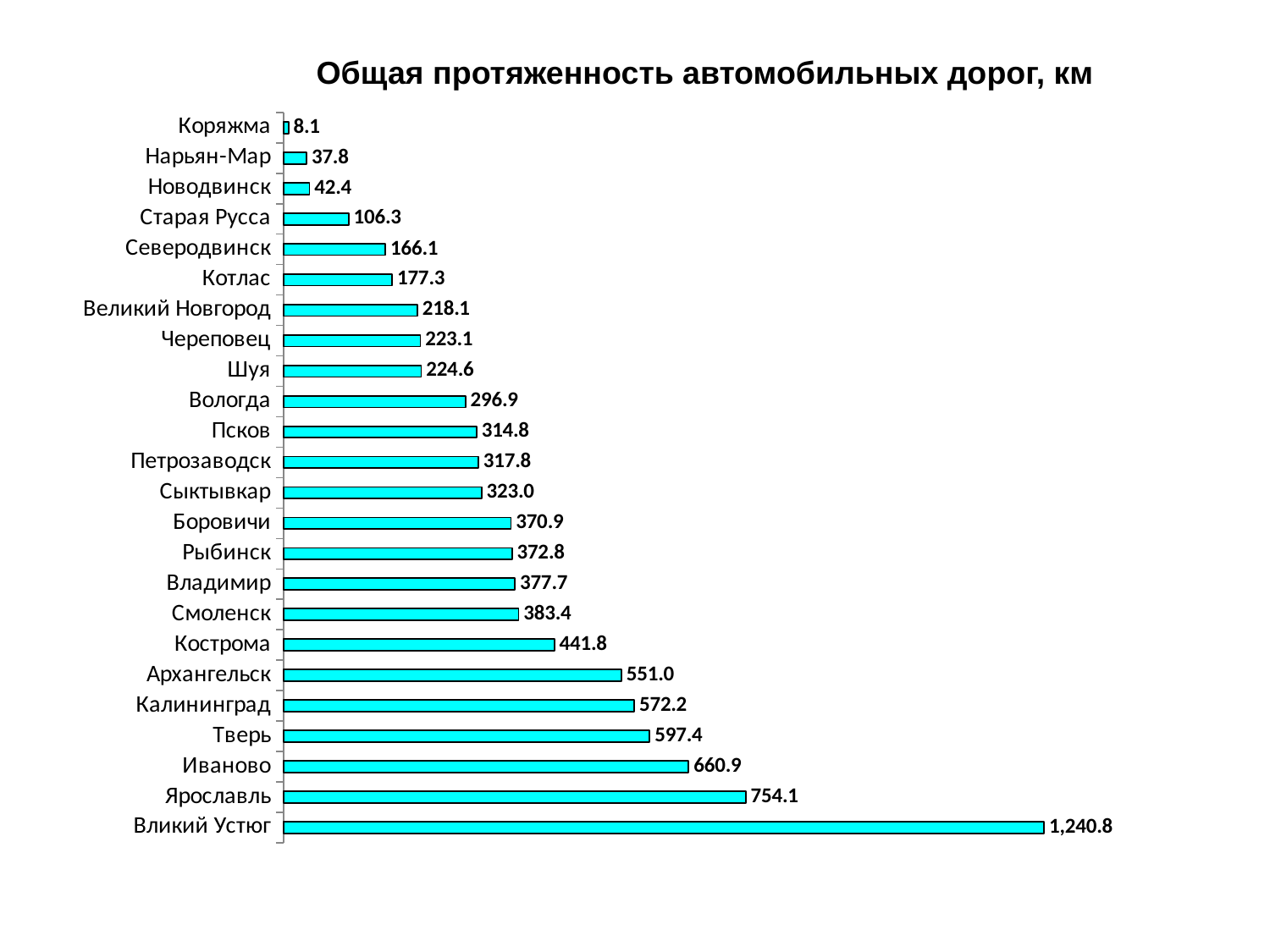
What is the total road length for Ярославль? 754.1 Which has a larger value, Котлас or Вологда? Вологда What is the value shown for Северодвинск? 166.1 What kind of chart is shown on the slide? Bar chart What is the title of the chart? Общая протяженность автомобильных дорог, км What is the difference between the values for Вликий Устюг and Ярославль? 486.7 How many cities are shown in the chart? 24 Which has a larger value, Кострома or Смоленск? Кострома Which city has the longest total road length? Вликий Устюг What is the difference between the values for Ярославль and Иваново? 93.2 Which city has the shortest total road length? Коряжма What is the value shown for Калининград? 572.2